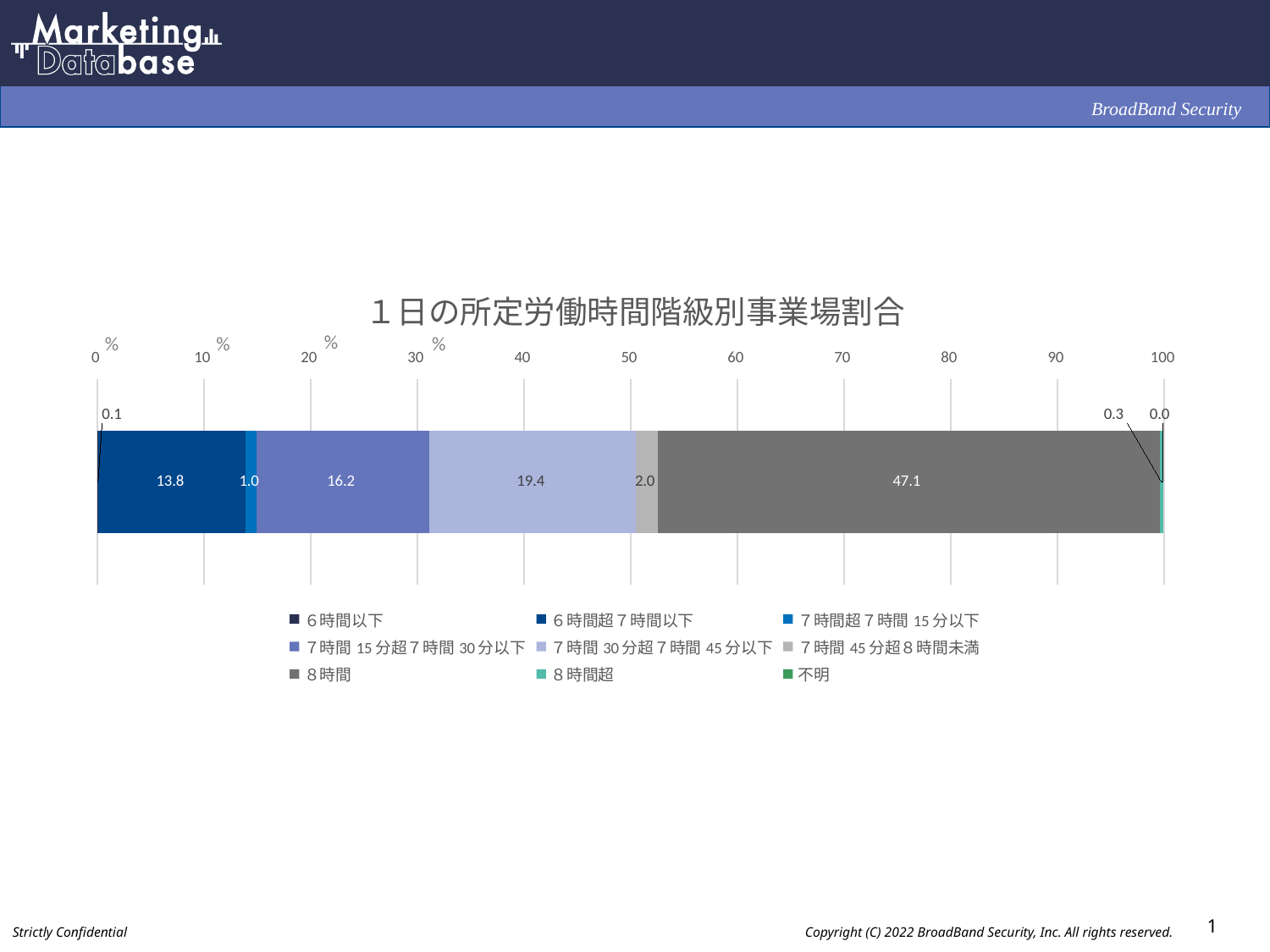
What is the value for 7時間30分超7時間45分以下? 19.4 What is the value for 8時間超? 0.3 What is the value for 8時間? 47.1 Which is larger, the value for 6時間超7時間以下 or the value for 7時間45分超8時間未満? 6時間超7時間以下 Which category has the lowest share? 不明 How many series does the legend list? 9 Which category has the highest share? 8時間 What is the value for 6時間超7時間以下? 13.8 What type of chart is shown on the slide? stacked bar chart What is the title of the chart? １日の所定労働時間階級別事業場割合 What is the value for 7時間15分超7時間30分以下? 16.2 What is the difference between the values for 7時間30分超7時間45分以下 and 7時間15分超7時間30分以下? 3.2